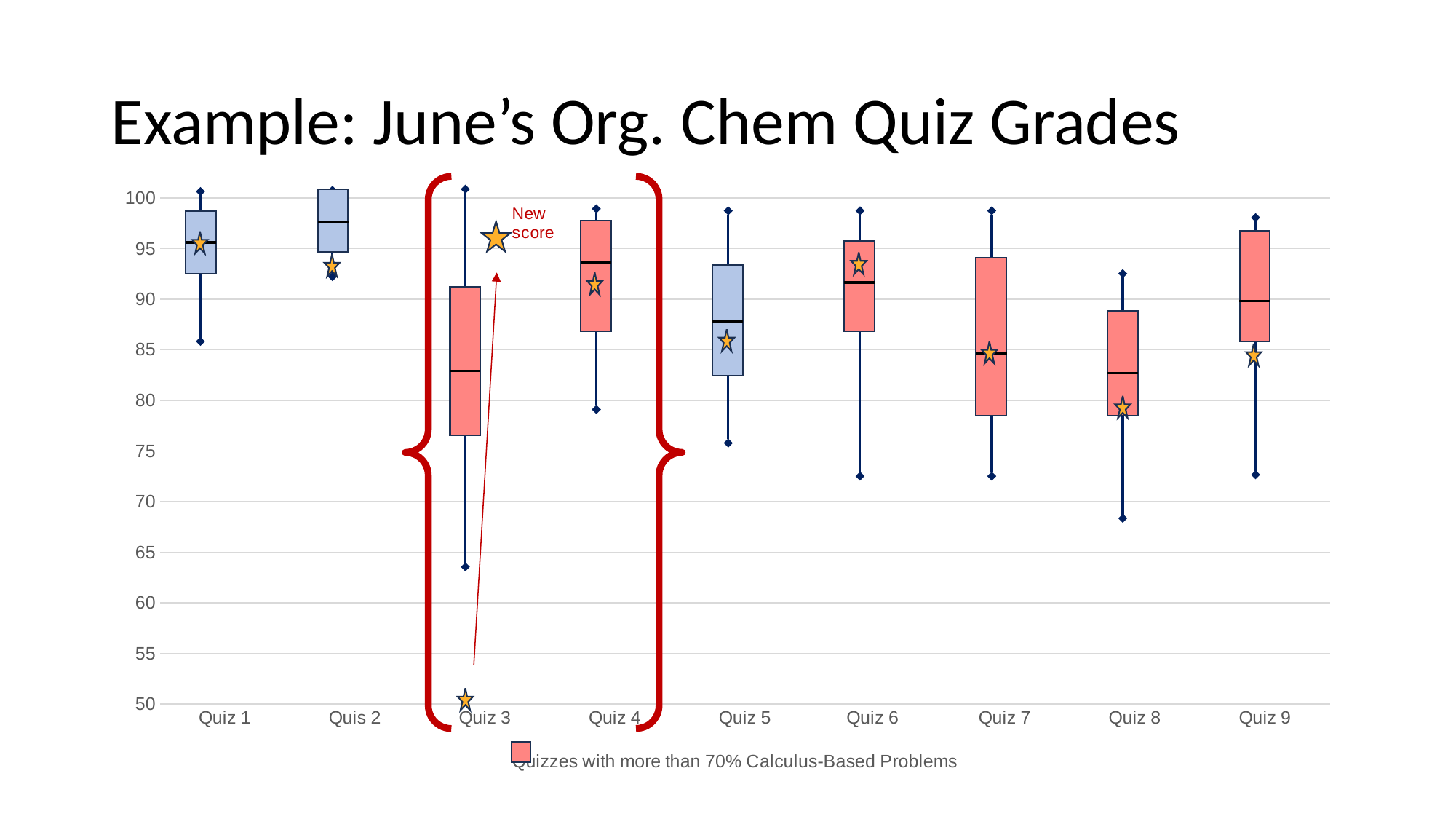
Is the star (June's score) for Quiz 6 greater or less than 90? greater What does the legend say the red boxes represent? Quizzes with more than 70% Calculus-Based Problems Is the median line for Quiz 3 greater or less than 80? greater How many quizzes are shown along the x axis? 9 Is the star (June's score) for Quiz 3 greater or less than 55? less What is the title of the slide? Example: June's Org. Chem Quiz Grades Which quiz has the lowest star (June's score)? Quiz 3 How many quizzes are drawn with red boxes? 6 Which quiz has the higher star (June's score), Quiz 3 or Quiz 4? Quiz 4 Which quiz has the higher median line, Quis 2 or Quiz 5? Quis 2 What kind of chart is shown on the slide? Box plot (box-and-whisker chart)